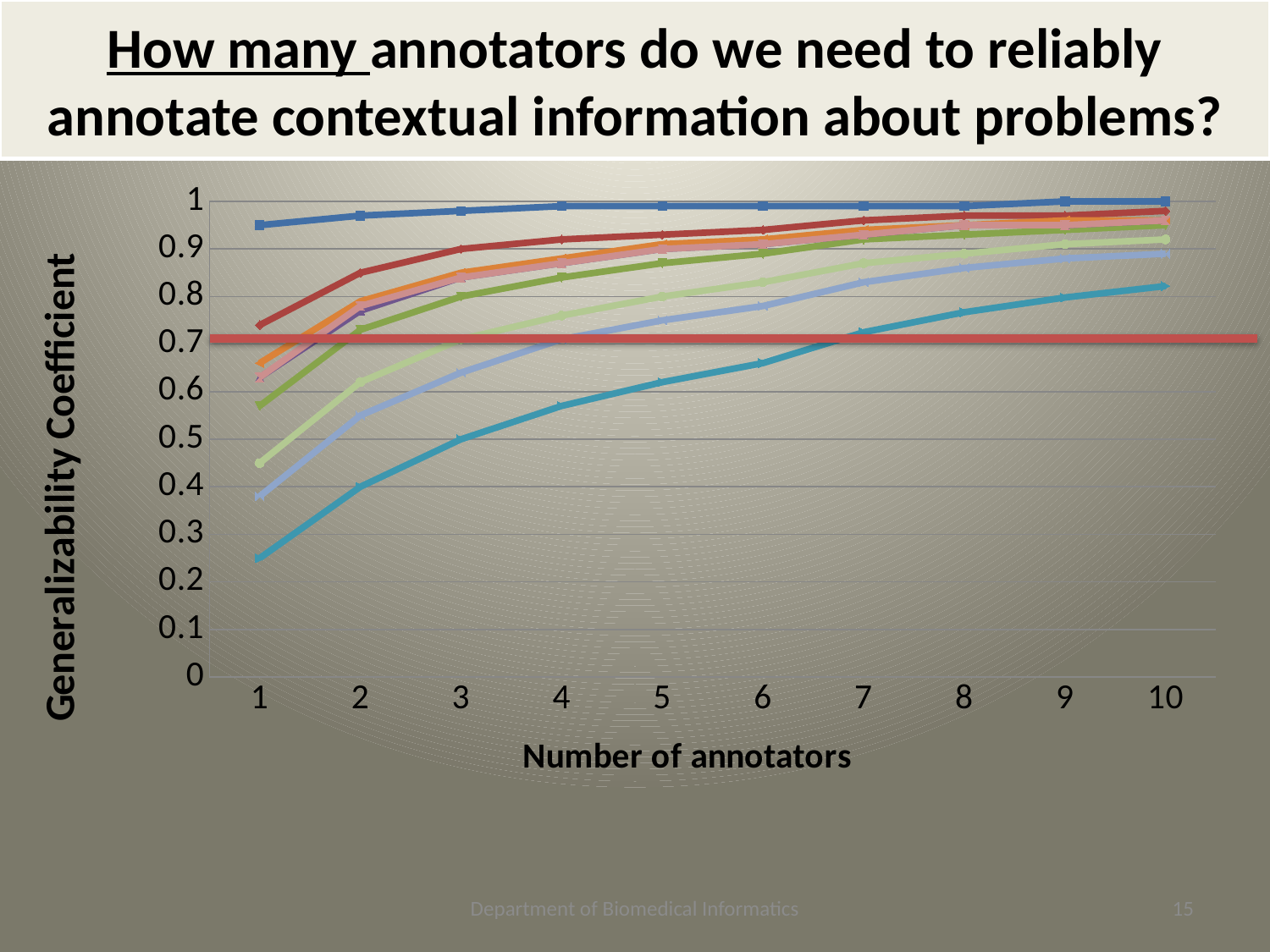
Which y-axis gridline does the horizontal red reference line lie on? 0.7 Do the plotted lines generally rise or fall as the number of annotators increases? rise What kind of chart is shown on the slide? line chart What is the highest value shown on the y axis? 1 What is the title of the x axis of the chart? Number of annotators How many values of the number of annotators are shown along the x axis? 10 Is the value of the lowest line at 10 annotators greater or less than 0.7? greater Is the value of the lowest line at 5 annotators greater or less than 0.7? less Is the value of the lowest line at 1 annotator greater or less than 0.3? less What is the title of the y axis of the chart? Generalizability Coefficient